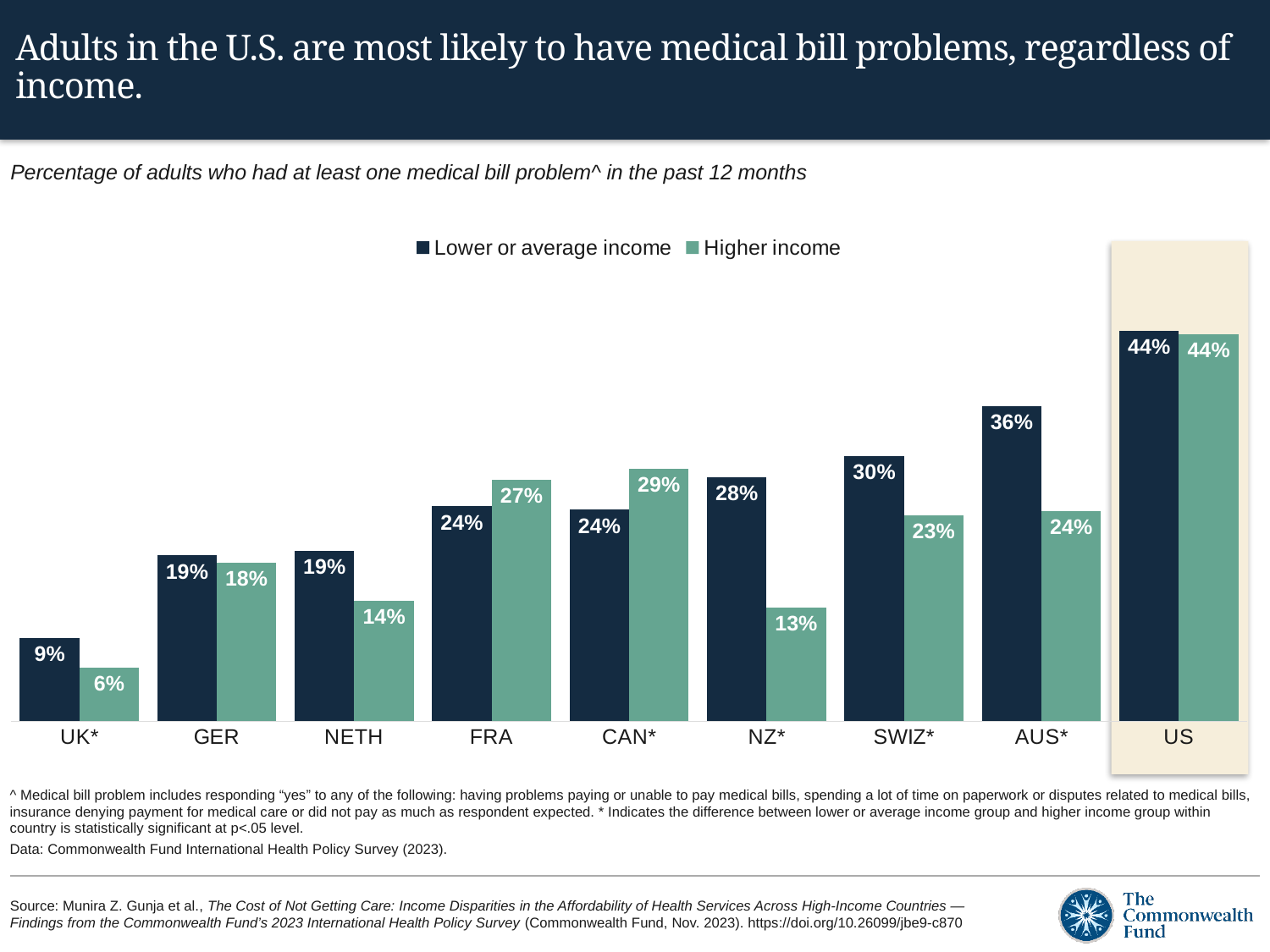
How many countries are shown on the x axis? 9 Which series is shown in dark navy in the legend? Lower or average income What is the value for Lower or average income in the US? 44% How many series does the legend list? 2 What is the value for Higher income in FRA? 27% Which country has the lowest value for Higher income? UK* What kind of chart is shown on the slide? Bar chart What is the value for Higher income in NZ*? 13% What is the difference between the Lower or average income values for SWIZ* and GER? 11% Which country has the highest value for Lower or average income? US Which is larger in CAN*: the Lower or average income value or the Higher income value? Higher income What is the difference between the Lower or average income and Higher income values for AUS*? 12%